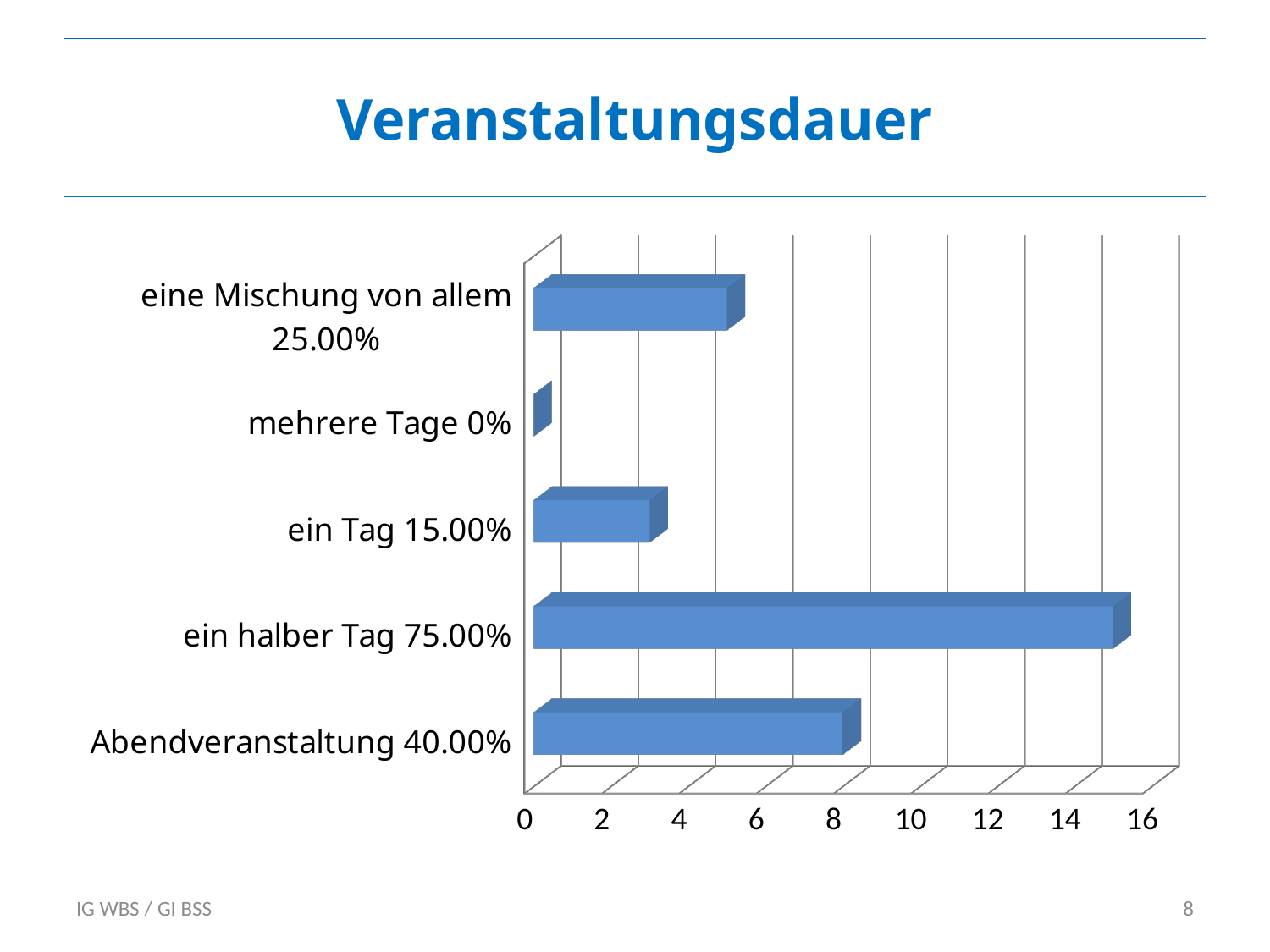
Is the value for ein Tag greater or less than 4? less What kind of chart is shown on the slide? bar chart How many categories does the chart show? 5 What percentage is printed in the category label for ein halber Tag? 75.00% Which bar is longer, Abendveranstaltung or ein Tag? Abendveranstaltung Which category has the longest bar? ein halber Tag 75.00% Is the value for Abendveranstaltung greater or less than 6? greater What is the highest value shown on the horizontal axis? 16 What is the title of the chart? Veranstaltungsdauer Which category has the shortest bar? mehrere Tage 0% Is the value for ein halber Tag greater or less than 14? greater Which bar is longer, eine Mischung von allem or ein halber Tag? ein halber Tag